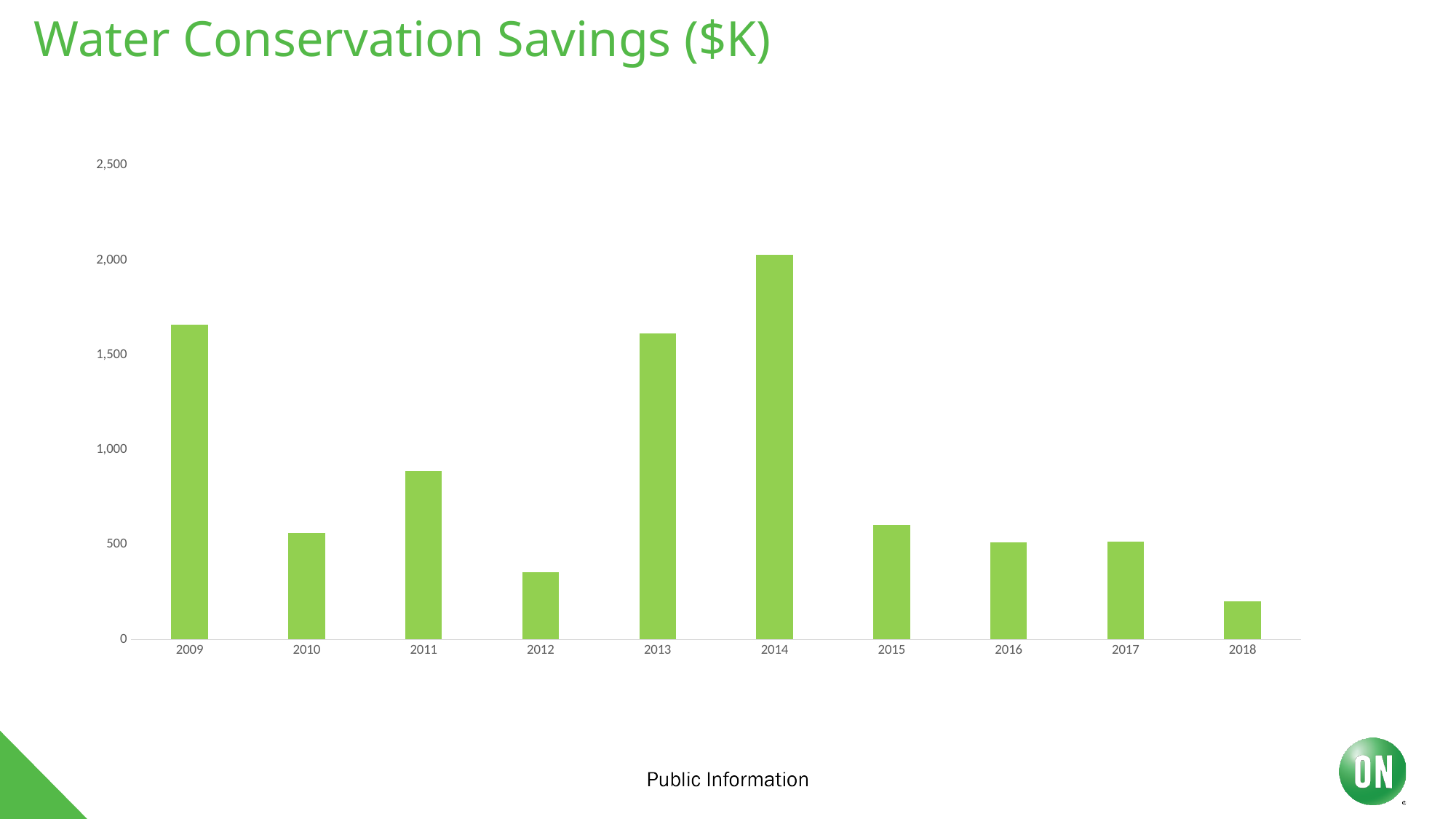
Which year has the lowest water conservation savings? 2018 How many years are shown on the x axis of the chart? 10 What is the title of the chart on the slide? Water Conservation Savings ($K) Is the value for 2012 greater or less than 500? less Is the value for 2018 greater or less than 500? less Is the value for 2009 greater or less than 1,500? greater What kind of chart is shown on the slide? bar chart Which year has the larger value, 2011 or 2010? 2011 Which year has the highest water conservation savings? 2014 Do the values rise or fall from 2014 to 2018? fall